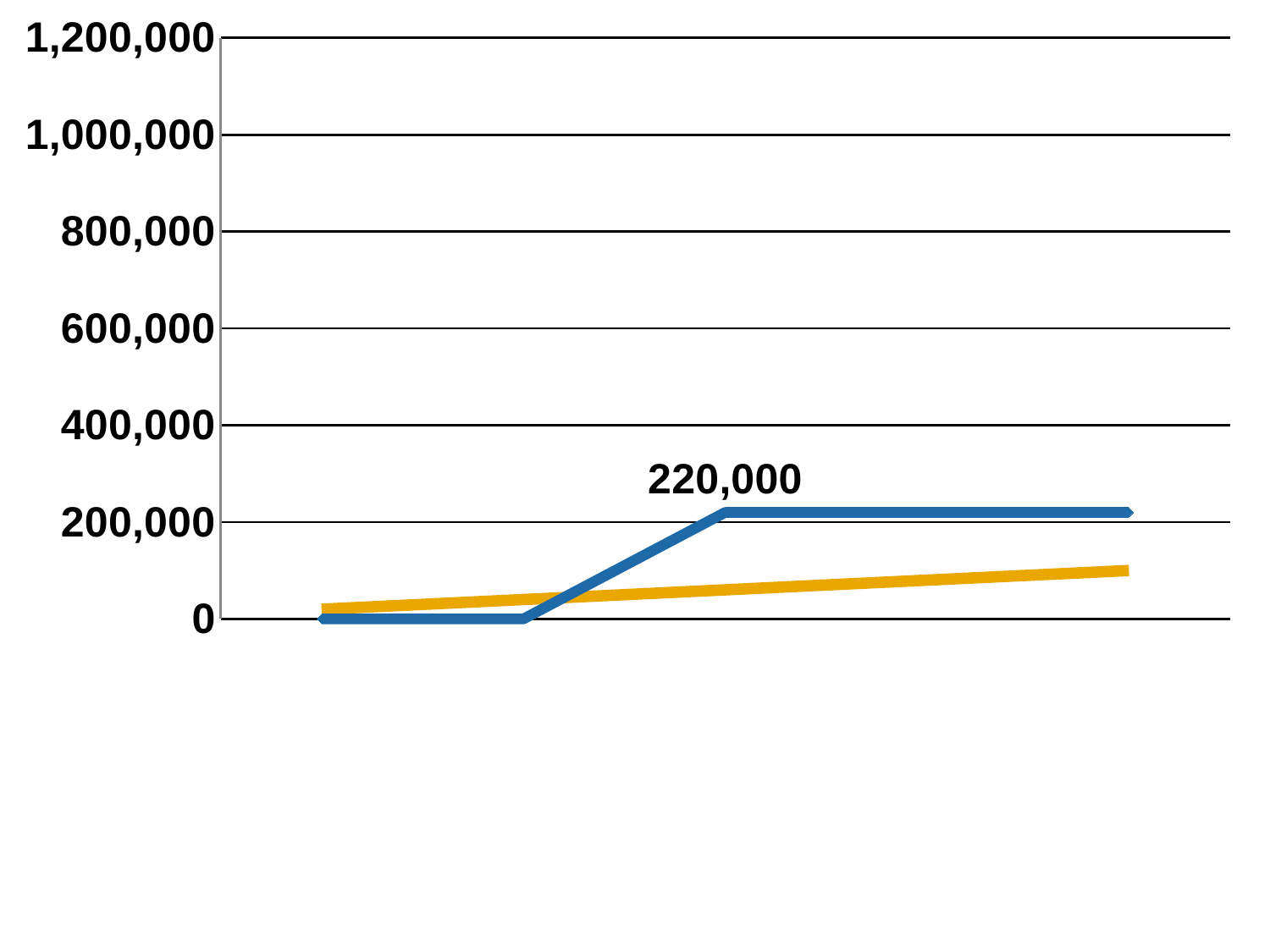
At the rightmost point, which line is higher, the blue line or the yellow line? blue line Does the yellow line rise or fall from left to right? rise At the leftmost point, which line is higher, the blue line or the yellow line? yellow line What value is printed as a data label on the blue line? 220,000 Is the value of the yellow line at its rightmost point greater or less than 200,000? less What colours are the two lines on the chart? blue and yellow What is the highest value shown on the vertical axis? 1,200,000 What kind of chart is shown on the slide? line chart What is the highest value reached by the blue line? 220,000 Is the labelled value on the blue line greater or less than 400,000? less How many lines are plotted on the chart? 2